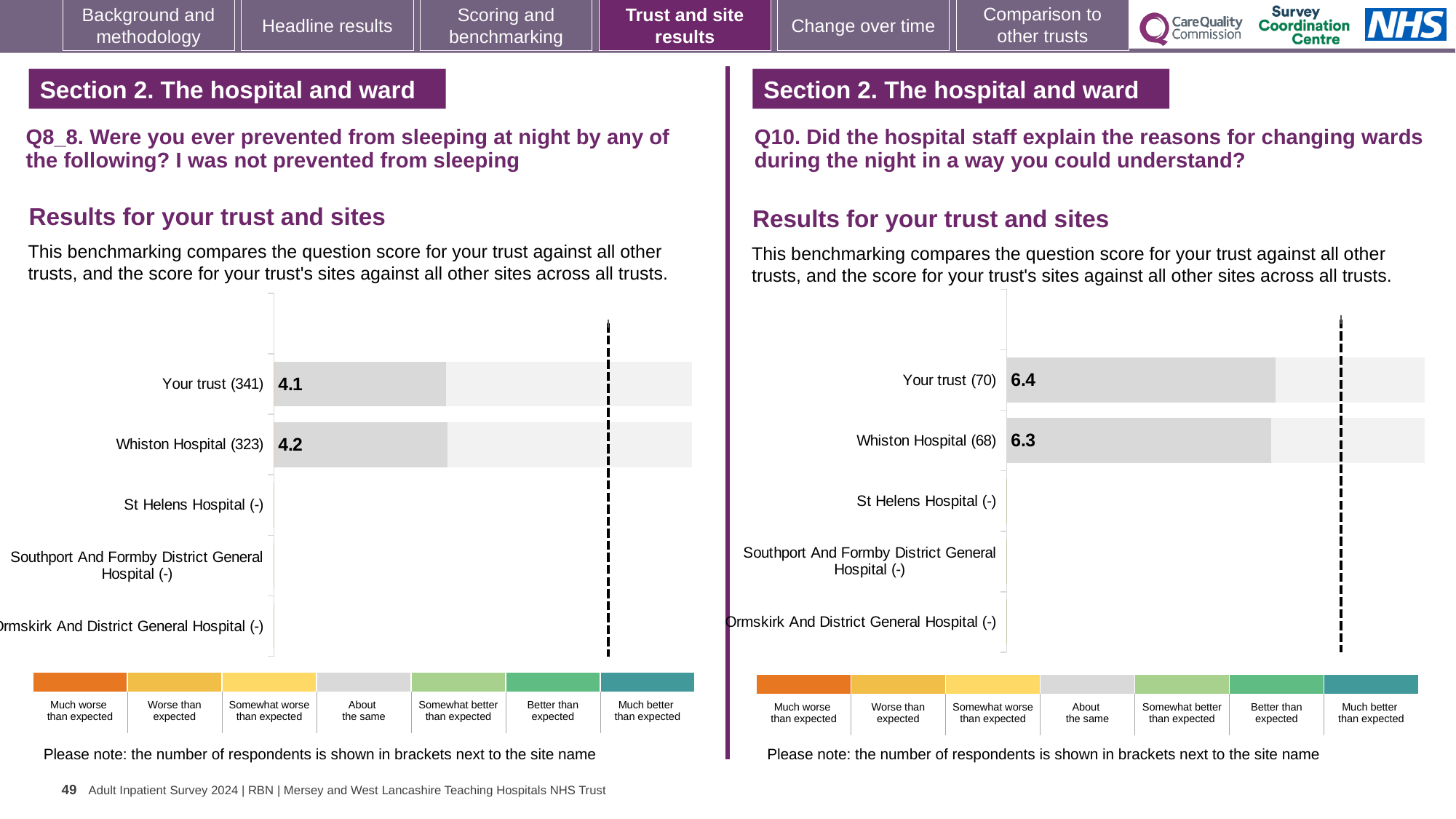
What type of chart is used on the Q10 chart (right)? Bar chart On the Q10 chart (right), which has the higher score, Your trust or Whiston Hospital? Your trust On the Q8_8 chart (left), which has the higher score, Your trust or Whiston Hospital? Whiston Hospital On the Q10 chart (right), what is the score for Your trust (70)? 6.4 On the Q8_8 chart (left), what is the score for Your trust (341)? 4.1 On the Q8_8 chart (left), how many of the listed sites have a plotted bar? 2 On the Q10 chart (right), how many respondents are shown in brackets for Your trust? 70 How many sites/categories are listed on the Q8_8 chart (left)? 5 On the Q8_8 chart (left), what is the difference between the Whiston Hospital score and the Your trust score? 0.1 On the Q10 chart (right), what is the difference between the Your trust score and the Whiston Hospital score? 0.1 On the Q8_8 chart (left), what is the score for Whiston Hospital (323)? 4.2 On the Q10 chart (right), what is the score for Whiston Hospital (68)? 6.3